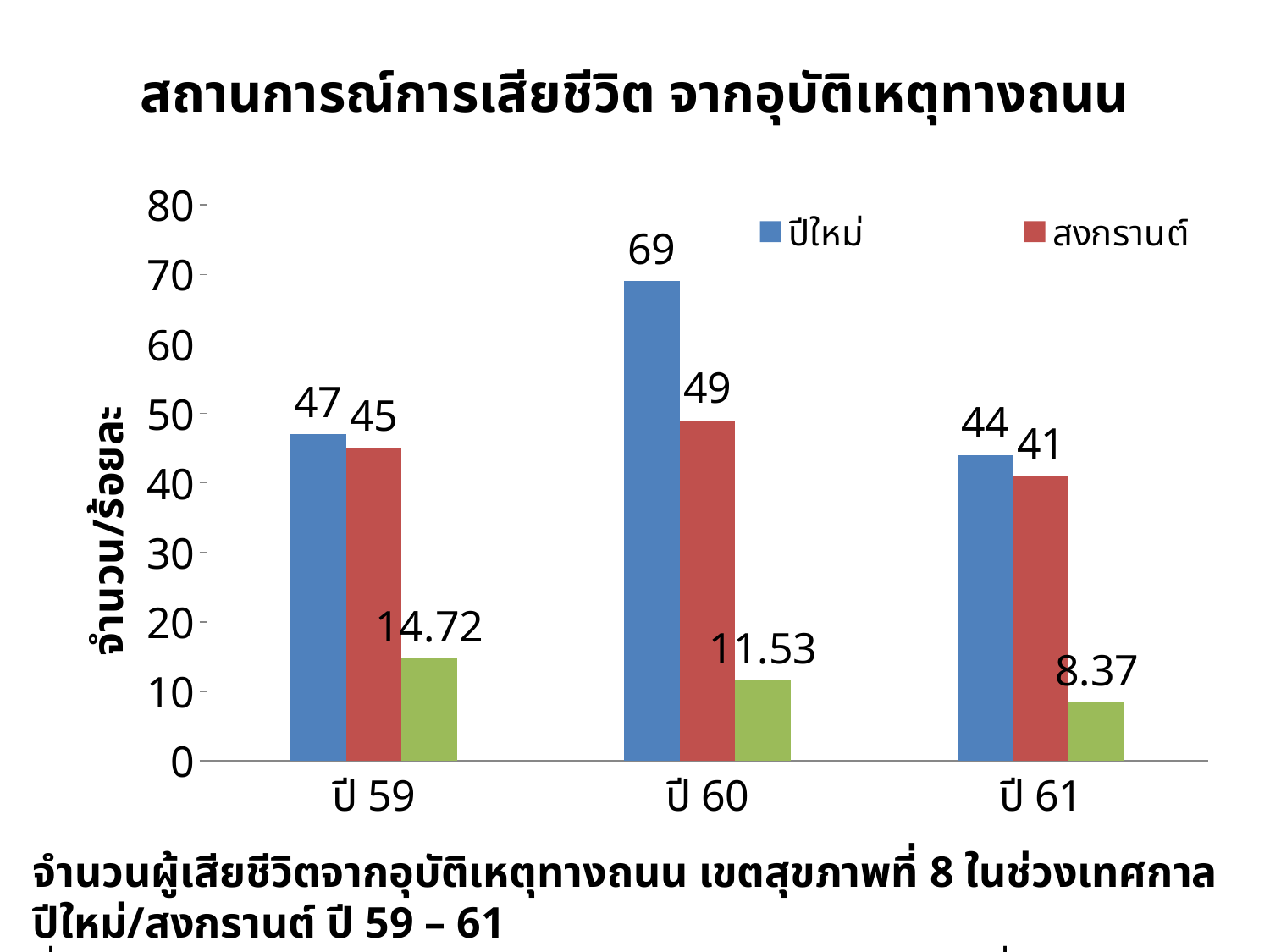
What is the difference between the ปีใหม่ values for ปี 60 and ปี 61? 25 Do the values of the green bars rise or fall from ปี 59 to ปี 61? fall What is the value of สงกรานต์ for ปี 61? 41 Which year has the lowest value for สงกรานต์? ปี 61 How many year categories are shown on the x axis? 3 Which year has the highest value for ปีใหม่? ปี 60 In ปี 59, which is larger, ปีใหม่ or สงกรานต์? ปีใหม่ How many series does the legend list? 2 What kind of chart is shown on the slide? bar chart What is the value of ปีใหม่ for ปี 60? 69 What is the difference between ปีใหม่ and สงกรานต์ in ปี 60? 20 What is the value of ปีใหม่ for ปี 59? 47